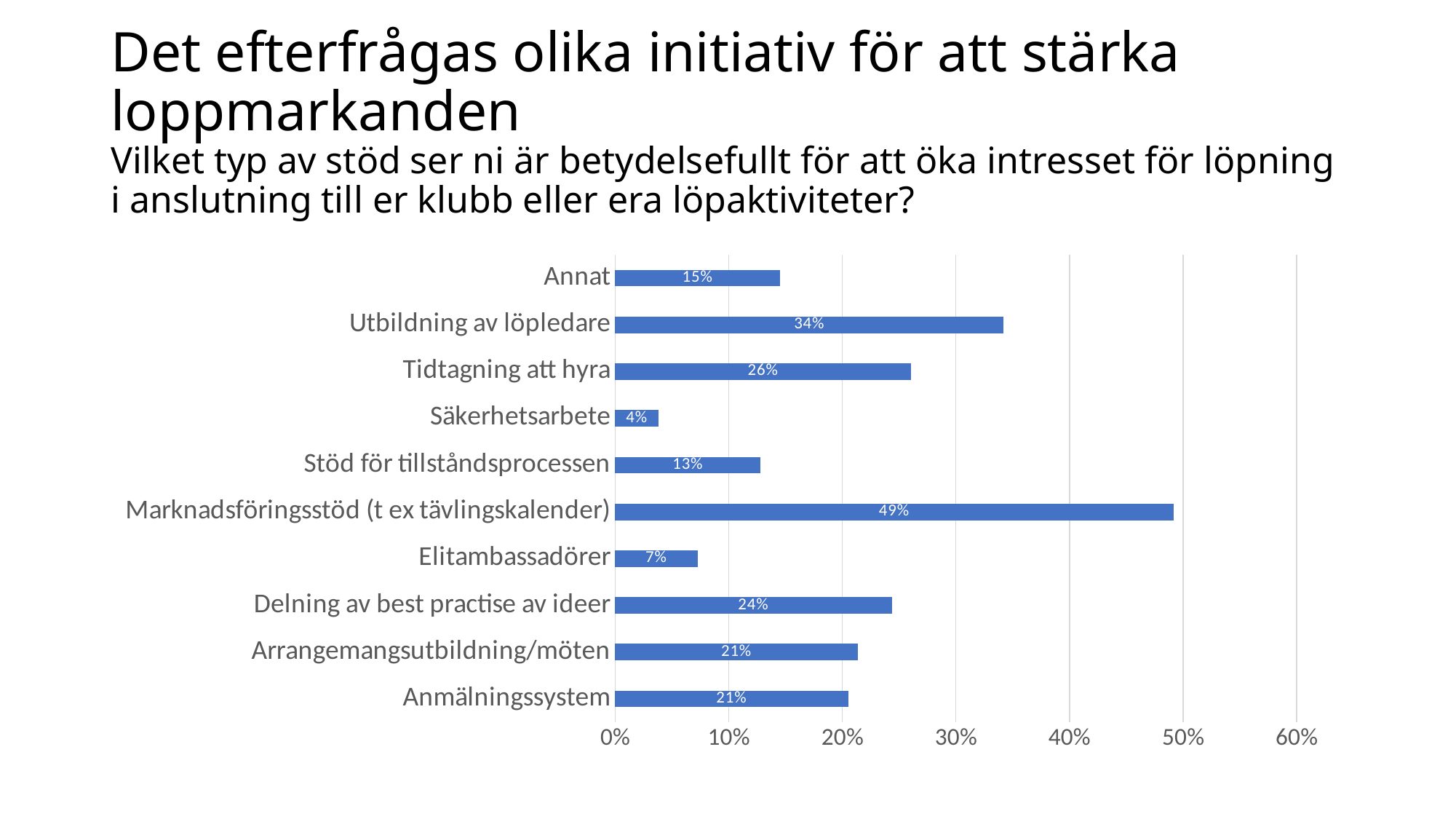
Is the value for Elitambassadörer greater or less than 10%? less Which category has the lowest value? Säkerhetsarbete Which category has the highest value? Marknadsföringsstöd (t ex tävlingskalender) What is the value for Delning av best practise av ideer? 24% Which is larger, the value for Annat or the value for Stöd för tillståndsprocessen? Annat What is the value for Marknadsföringsstöd (t ex tävlingskalender)? 49% What is the highest value shown on the x axis? 60% What kind of chart is shown on the slide? bar chart What is the difference between the values for Utbildning av löpledare and Tidtagning att hyra? 8% What is the value for Säkerhetsarbete? 4% How many categories are shown in the chart? 10 What is the value for Utbildning av löpledare? 34%